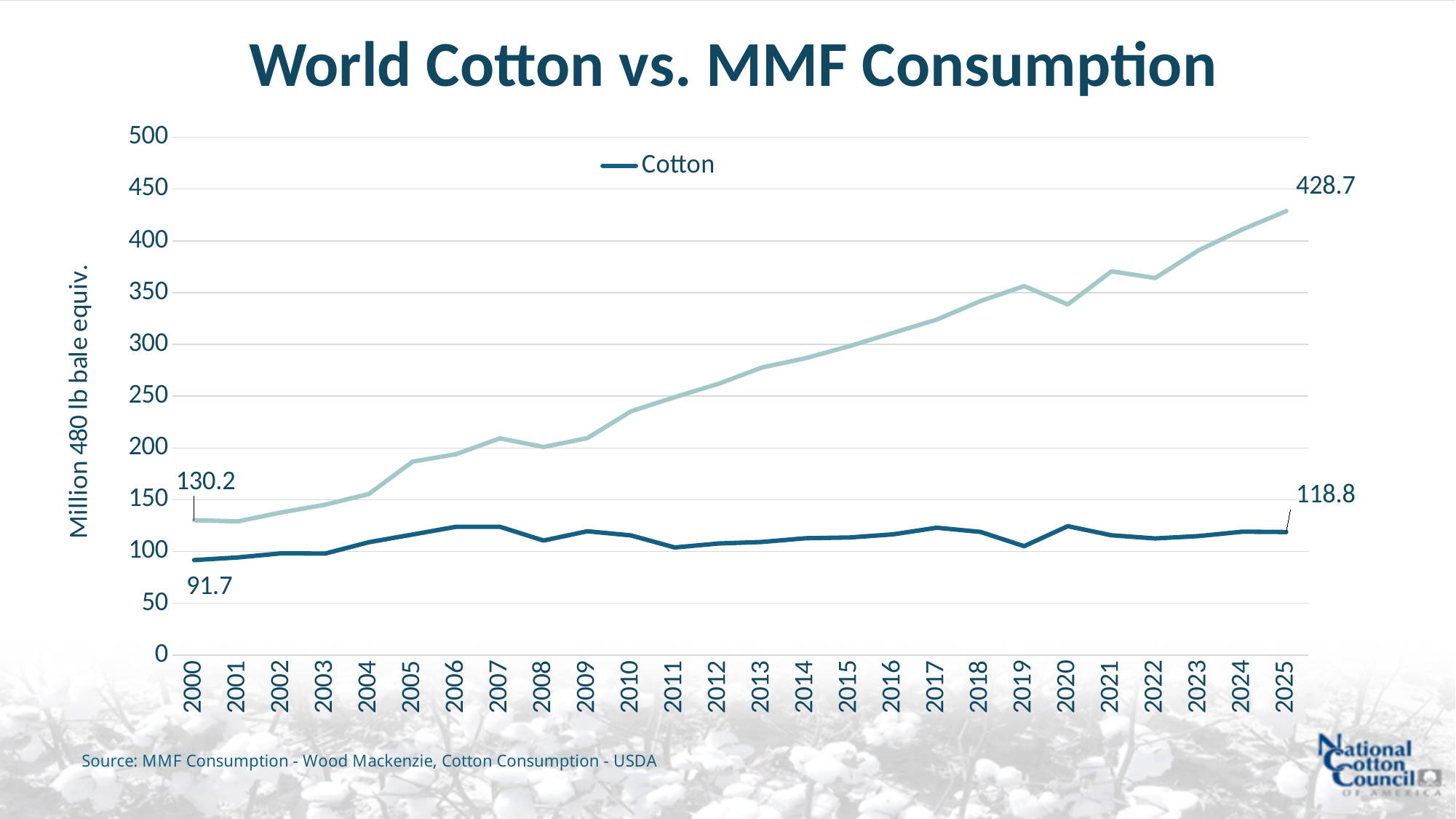
What is the value of the MMF (lighter) line in 2000? 130.2 Is the Cotton value for 2010 greater or less than 150? less What is the value of the MMF (lighter) line in 2025? 428.7 What is the label on the vertical axis? Million 480 lb bale equiv. By how much does the MMF (lighter) line's 2025 value exceed its 2000 value? 298.5 What is the Cotton consumption value for 2025? 118.8 In 2025, which is larger: the MMF (lighter) line value or the Cotton value? MMF How many years are shown on the x axis? 26 What type of chart is shown on the slide? line chart What is the Cotton consumption value for 2000? 91.7 Is the value of the MMF (lighter) line in 2020 greater or less than 300? greater What is the difference between the Cotton values for 2025 and 2000? 27.1